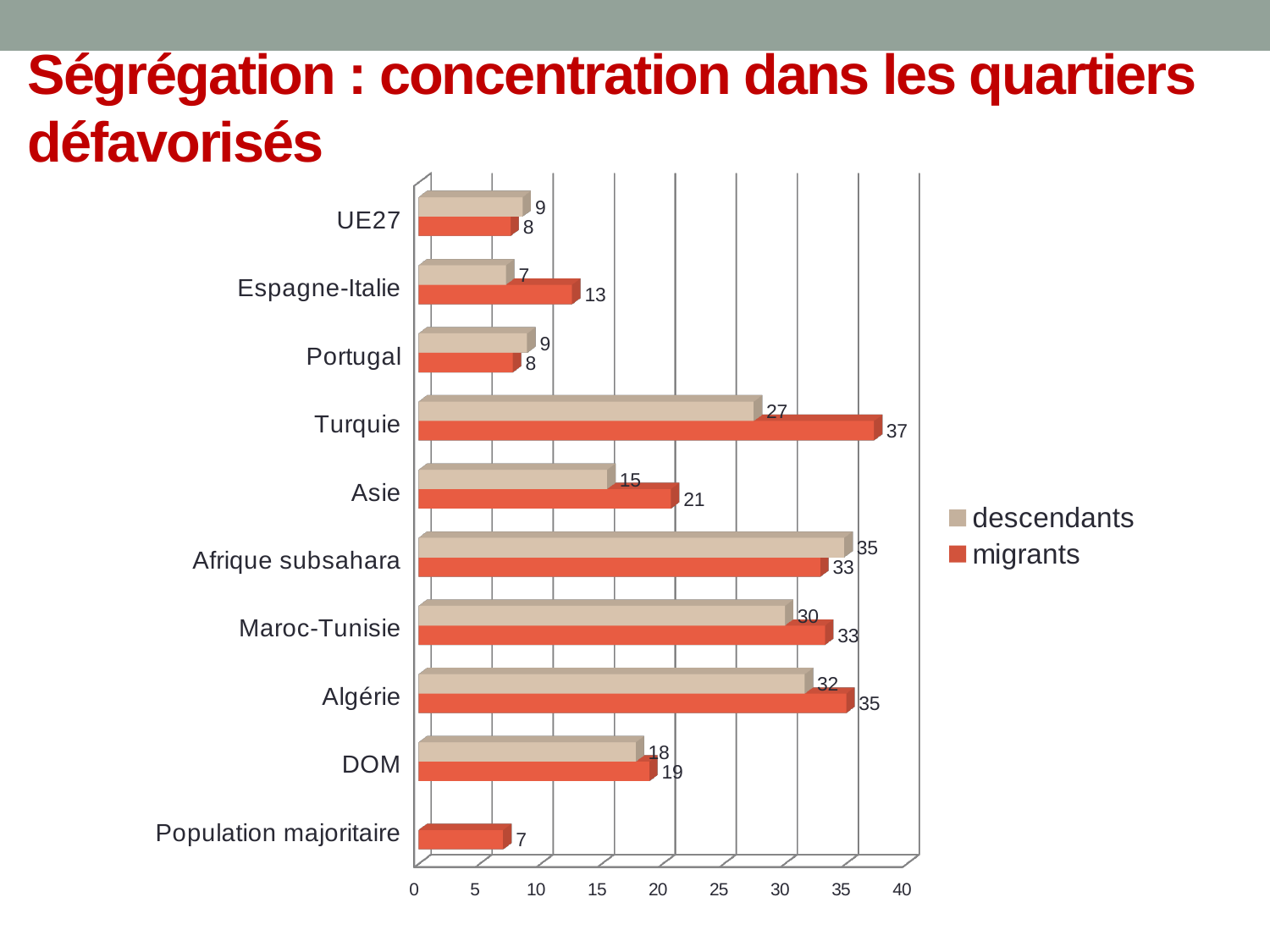
What kind of chart is shown on the slide? bar chart Which category has the highest migrants value? Turquie How many series does the legend list? 2 Which category has the lowest descendants value? Espagne-Italie What is the descendants value for Afrique subsahara? 35 What is the difference between the migrants and descendants values for Turquie? 10 For Espagne-Italie, which is larger: the migrants value or the descendants value? migrants Is the descendants value for Maroc-Tunisie greater or less than 25? greater Which series is shown in red in the legend? migrants How many categories are shown on the y axis? 10 What is the migrants value for Population majoritaire? 7 What is the migrants value for Turquie? 37